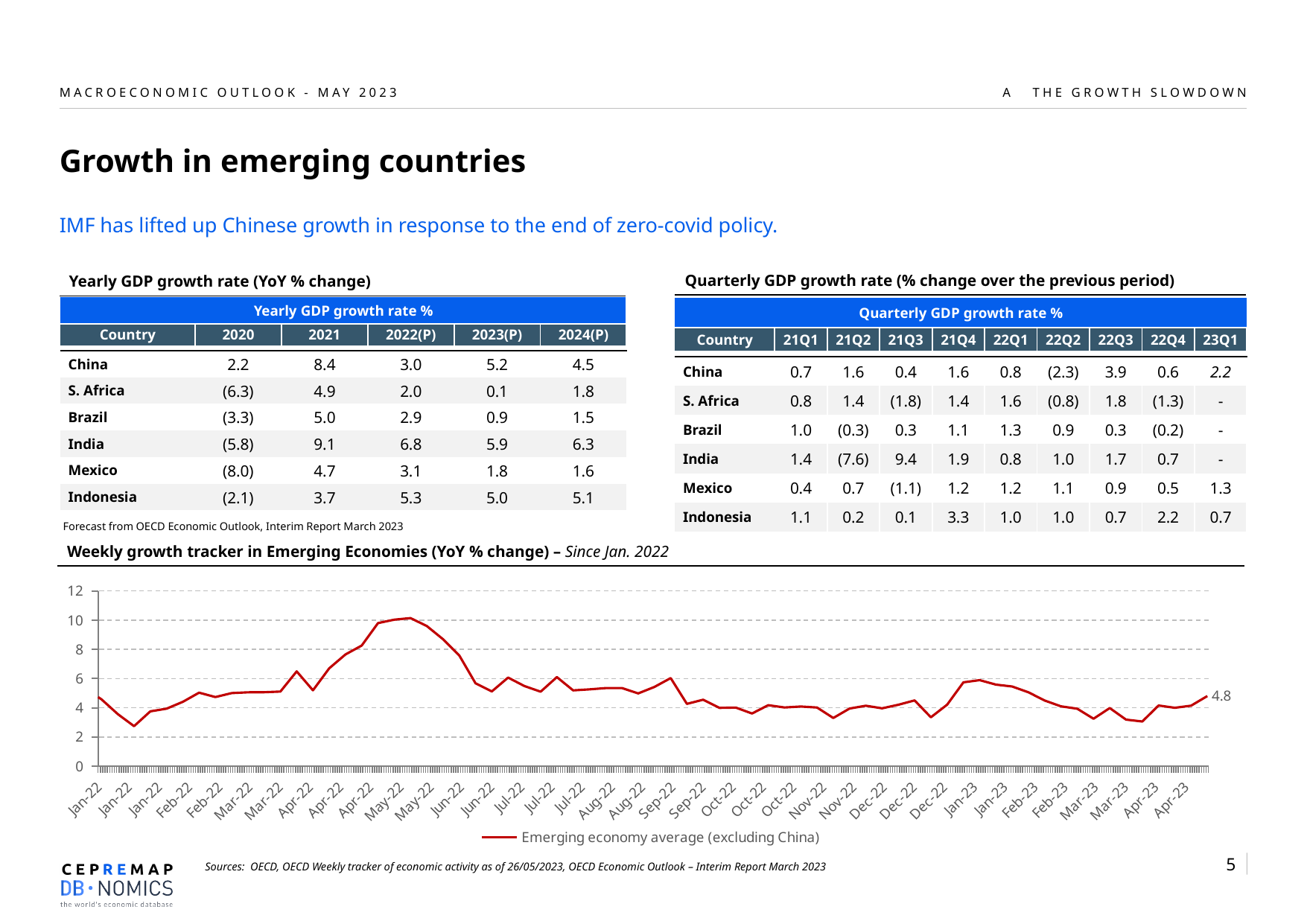
In the weekly growth tracker chart, is the peak value reached around May-22 greater or less than 8? greater In the weekly growth tracker chart, is the value in Mar-23 greater or less than 4? less In the weekly growth tracker chart, is the lowest value in Jan-22 greater or less than 4? less What is the name of the series shown in the weekly growth tracker chart? Emerging economy average (excluding China) How many series does the legend of the weekly growth tracker chart list? 1 Does the weekly growth tracker line rise or fall between Jan-23 and Mar-23? fall What is the title of the line chart on the slide? Weekly growth tracker in Emerging Economies (YoY % change) – Since Jan. 2022 What kind of chart is the 'Weekly growth tracker in Emerging Economies' chart? line chart Does the weekly growth tracker line rise or fall between Mar-22 and May-22? rise In which month does the weekly growth tracker line reach its highest value? May-22 What is the last value labelled on the weekly growth tracker line, at the end of Apr-23? 4.8